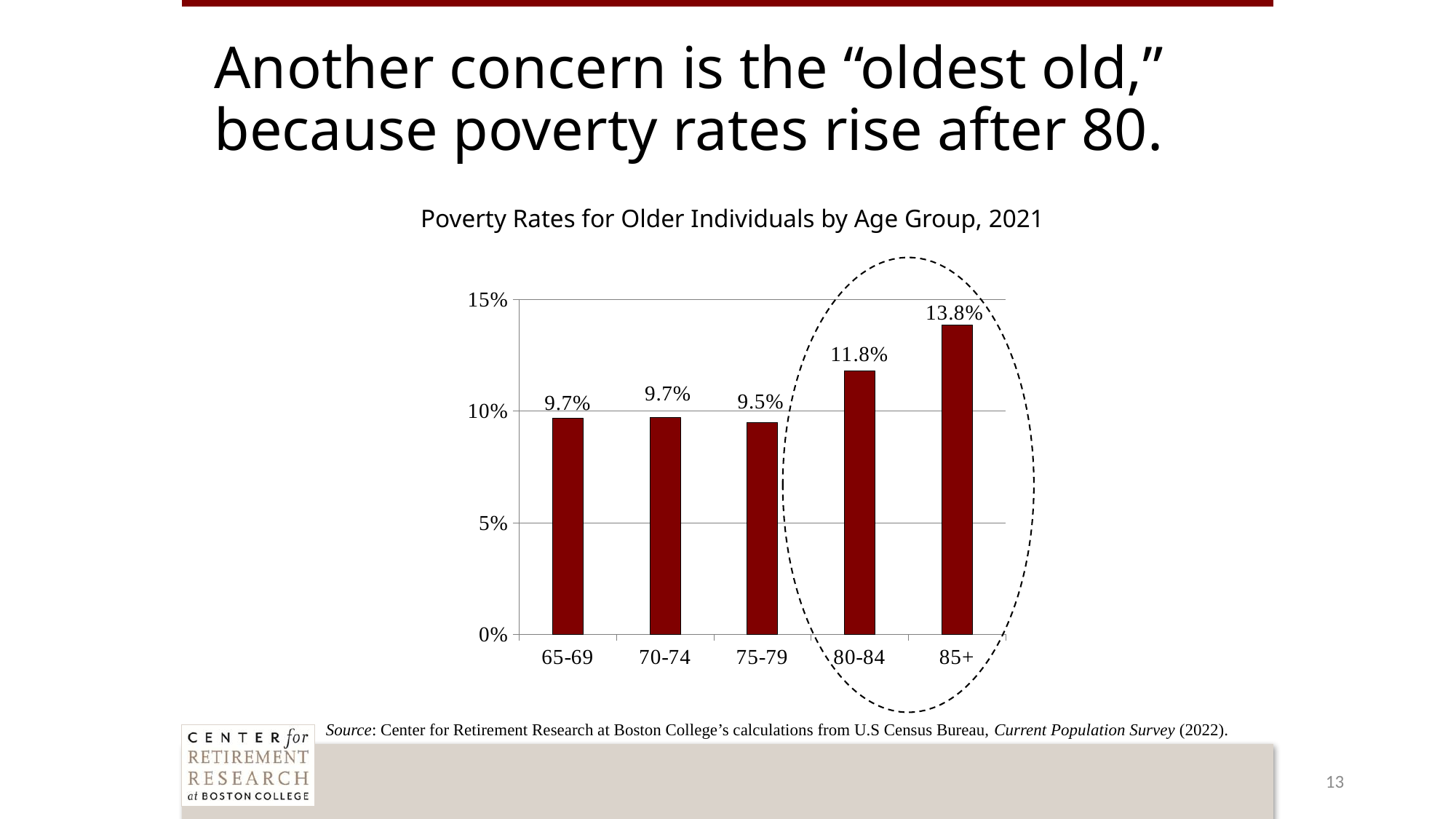
What is the difference between the poverty rates for the 85+ and 80-84 age groups? 2.0% How many age groups are shown in the chart? 5 Which age group has the highest poverty rate? 85+ What kind of chart is shown on the slide? Bar chart Which age group has the lowest poverty rate? 75-79 What is the poverty rate for the 85+ age group? 13.8% Which age group has a higher poverty rate, 75-79 or 80-84? 80-84 Is the poverty rate for the 85+ age group greater or less than 15%? less What is the poverty rate for the 80-84 age group? 11.8% What is the title of the chart? Poverty Rates for Older Individuals by Age Group, 2021 What is the poverty rate for the 65-69 age group? 9.7% What is the difference between the poverty rates for the 80-84 and 75-79 age groups? 2.3%